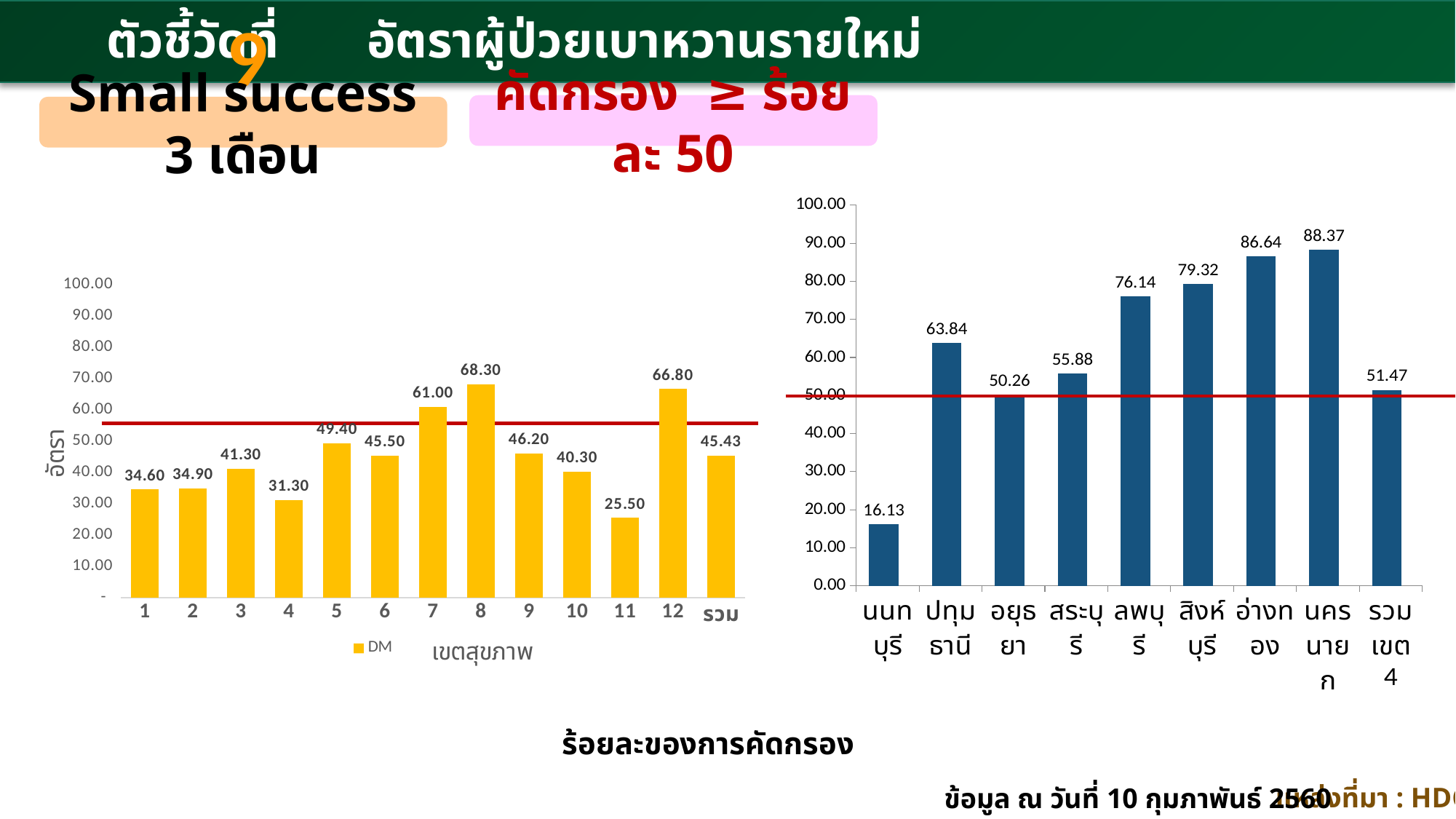
In the right chart (blue bars), which province has the highest value? นครนายก In the left chart (yellow bars), what is the value for category 8? 68.30 In the right chart (blue bars), what is the value for อ่างทอง? 86.64 In the left chart (yellow bars), how many bars are plotted? 13 In the right chart (blue bars), which province has the lowest value? นนทบุรี In the left chart (yellow bars), which category has the lowest value? 11 In the right chart (blue bars), how many bars are plotted? 9 What type of chart is the right chart? Bar chart In the right chart (blue bars), what is the difference between the values for นครนายก and นนทบุรี? 72.24 In the right chart (blue bars), which is larger, the value for ปทุมธานี or the value for สระบุรี? ปทุมธานี In the left chart (yellow bars), what is the difference between the values for category 12 and category 11? 41.30 In the left chart (yellow bars), what series name does the legend show? DM